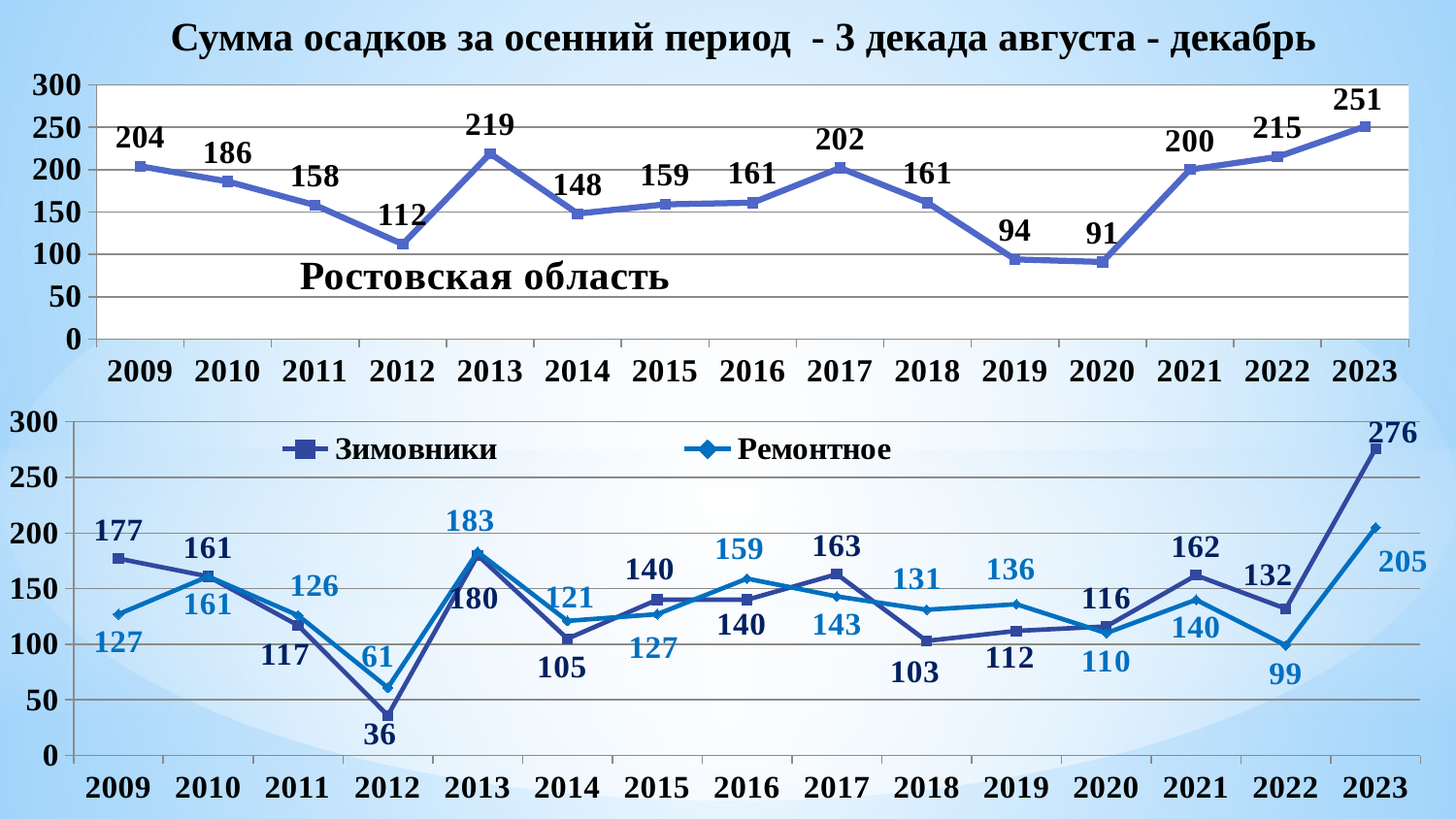
In the bottom chart, what is the value for Зимовники in 2012? 36 What kind of chart is the bottom chart? Line chart In the top chart (Ростовская область), which year has the highest value? 2023 In the bottom chart, which series has the higher value in 2009, Зимовники or Ремонтное? Зимовники In the top chart (Ростовская область), what is the difference between the values for 2023 and 2020? 160 In the bottom chart, what is the difference between Зимовники and Ремонтное in 2023? 71 In the top chart (Ростовская область), what is the value for 2013? 219 In the bottom chart, what is the value for Ремонтное in 2023? 205 In the top chart (Ростовская область), which year has the lowest value? 2020 In the top chart (Ростовская область), how many years are plotted on the x axis? 15 In the bottom chart, how many series does the legend list? 2 In the bottom chart, which year has the highest value for Ремонтное? 2023